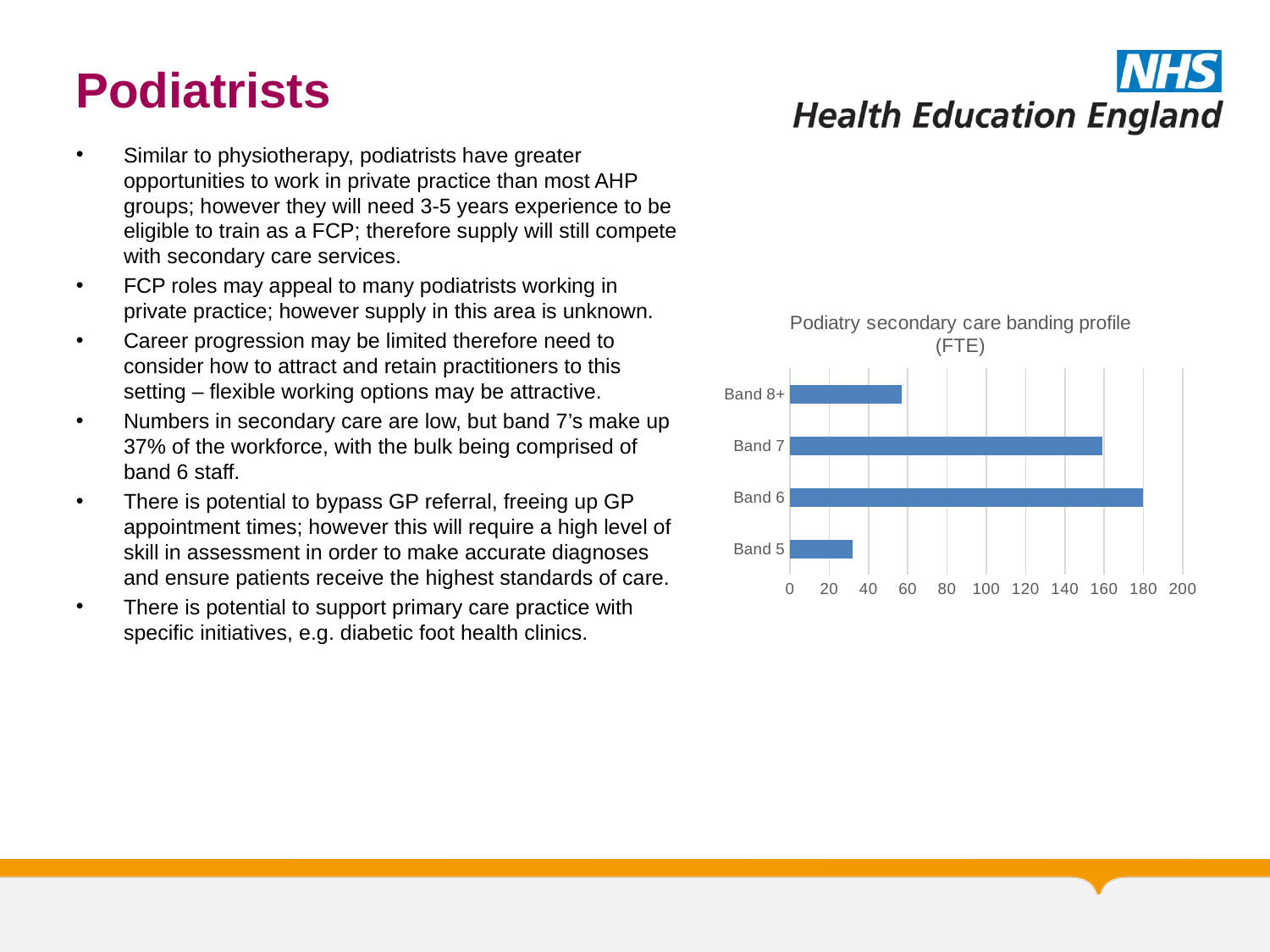
Is the value for Band 8+ greater or less than 40? greater Is the value for Band 5 greater or less than 40? less Which band has the highest value in the chart? Band 6 Which is larger, the value for Band 8+ or the value for Band 5? Band 8+ What is the title of the chart on the slide? Podiatry secondary care banding profile (FTE) Is the value for Band 6 greater or less than 160? greater Which band has the lowest value in the chart? Band 5 What is the maximum value shown on the horizontal axis of the chart? 200 Which is larger, the value for Band 6 or the value for Band 7? Band 6 What kind of chart is shown on the slide? bar chart How many bands are shown in the chart? 4